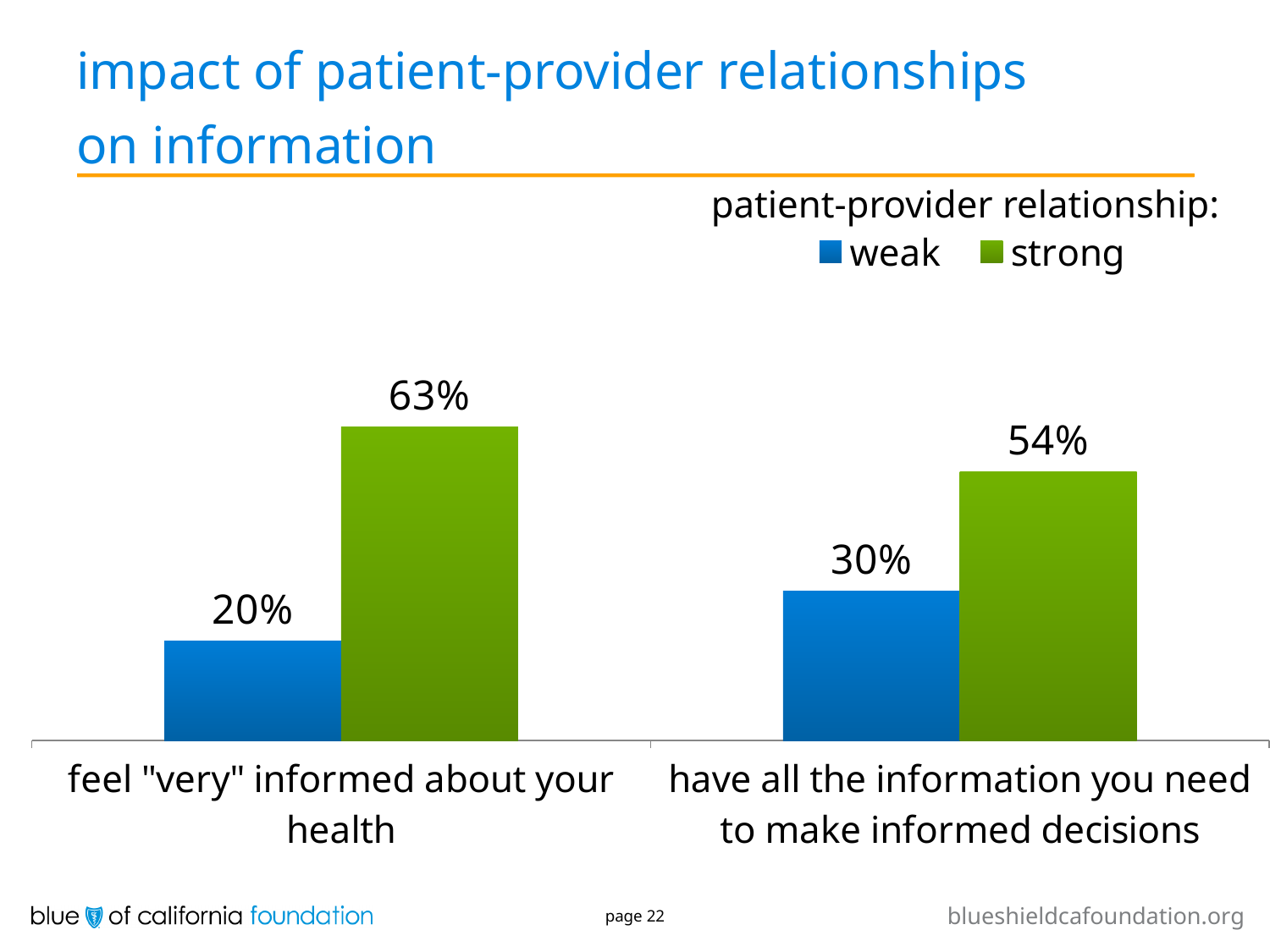
What kind of chart is shown on the slide? bar chart What is the value for "strong" in the "feel "very" informed about your health" category? 63% How many categories are shown on the x axis? 2 Which bar has the highest value on the chart? strong, feel "very" informed about your health (63%) What is the value for "weak" in the "feel "very" informed about your health" category? 20% What is the value for "weak" in the "have all the information you need to make informed decisions" category? 30% Which bar has the lowest value on the chart? weak, feel "very" informed about your health (20%) How many series does the legend list? 2 Which is larger: the "strong" value for "feel "very" informed about your health" or the "strong" value for "have all the information you need to make informed decisions"? feel "very" informed about your health (63%) What is the value for "strong" in the "have all the information you need to make informed decisions" category? 54% What is the difference between the "strong" and "weak" values for "have all the information you need to make informed decisions"? 24 percentage points What is the difference between the "strong" and "weak" values for "feel "very" informed about your health"? 43 percentage points